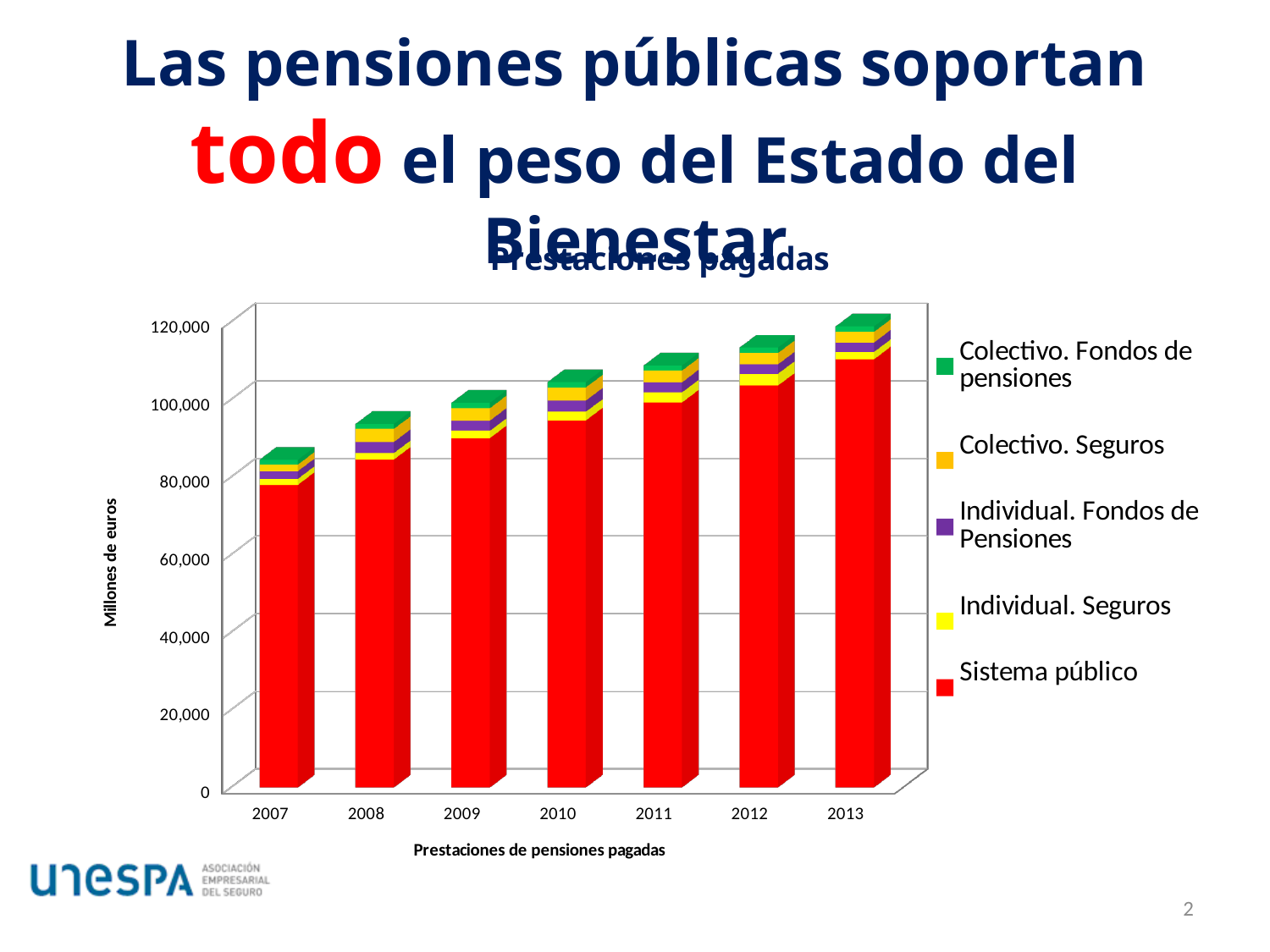
What colour represents the Sistema público series in the chart? red Which year has the highest total of prestaciones pagadas? 2013 Which year has the larger total, 2007 or 2013? 2013 Do the total prestaciones pagadas rise or fall from 2007 to 2013? rise Which year has the lowest total of prestaciones pagadas? 2007 What kind of chart is shown on the slide? stacked bar chart Is the Sistema público value for 2009 greater or less than 100,000? less How many series does the chart's legend list? 5 Is the total value for 2008 greater or less than 100,000? less Is the Sistema público value for 2013 greater or less than 100,000? greater How many years are shown on the x axis of the chart? 7